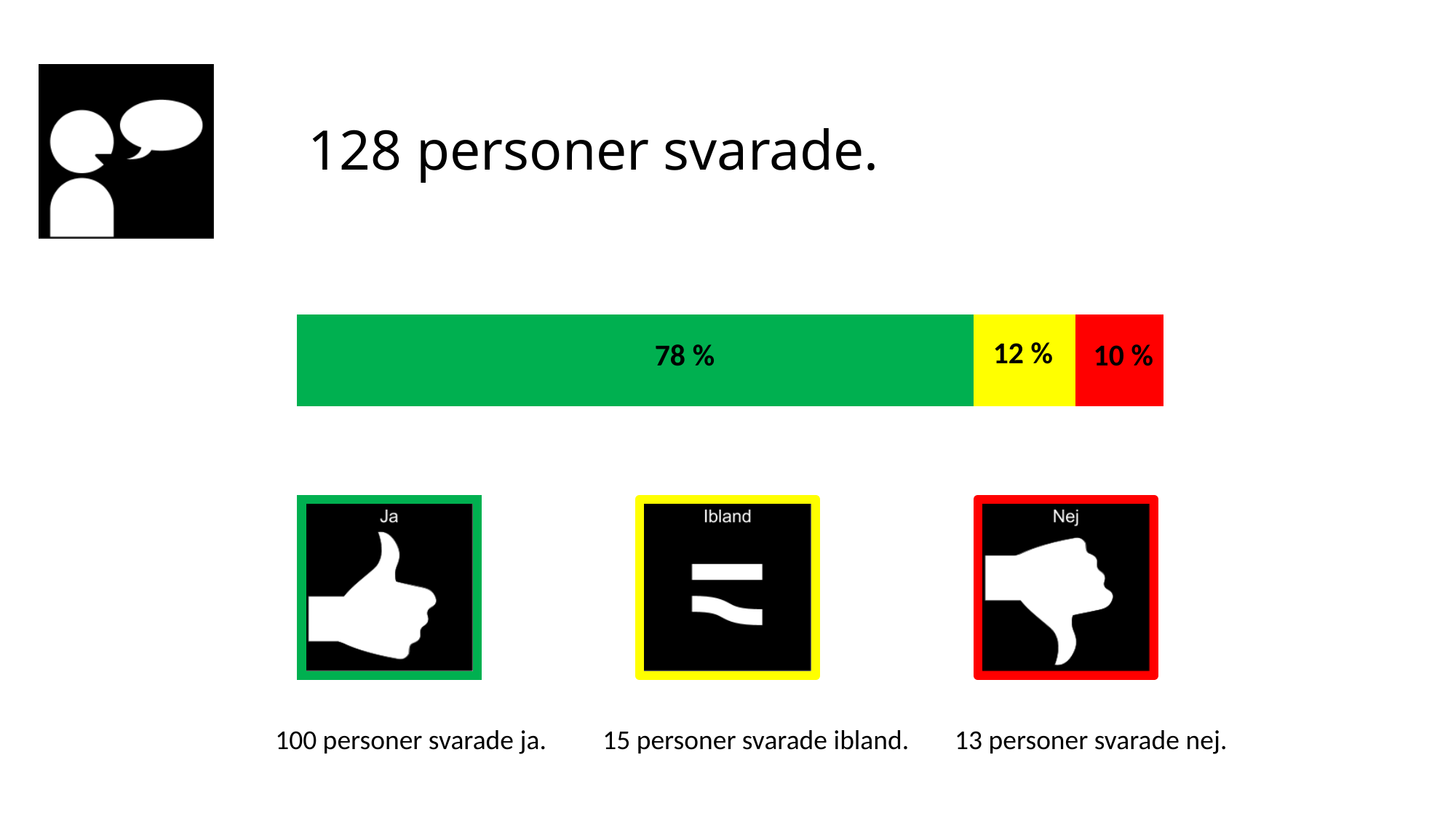
What percentage does the yellow "Ibland" segment of the bar show? 12 % What colour is the segment representing "Nej"? Red What kind of chart is shown on the slide? Stacked bar chart Which segment is larger, "Ibland" or "Nej"? Ibland Which answer category has the largest share of the bar? Ja How many people answered "Ja" according to the text below the chart? 100 What is the total of the three percentages shown in the bar? 100 % What percentage of respondents answered "Ja" (green segment)? 78 % What is the difference in percentage points between the "Ja" segment and the "Ibland" segment? 66 What percentage does the red "Nej" segment of the bar show? 10 % Which answer category has the smallest share of the bar? Nej How many segments does the stacked bar have? 3